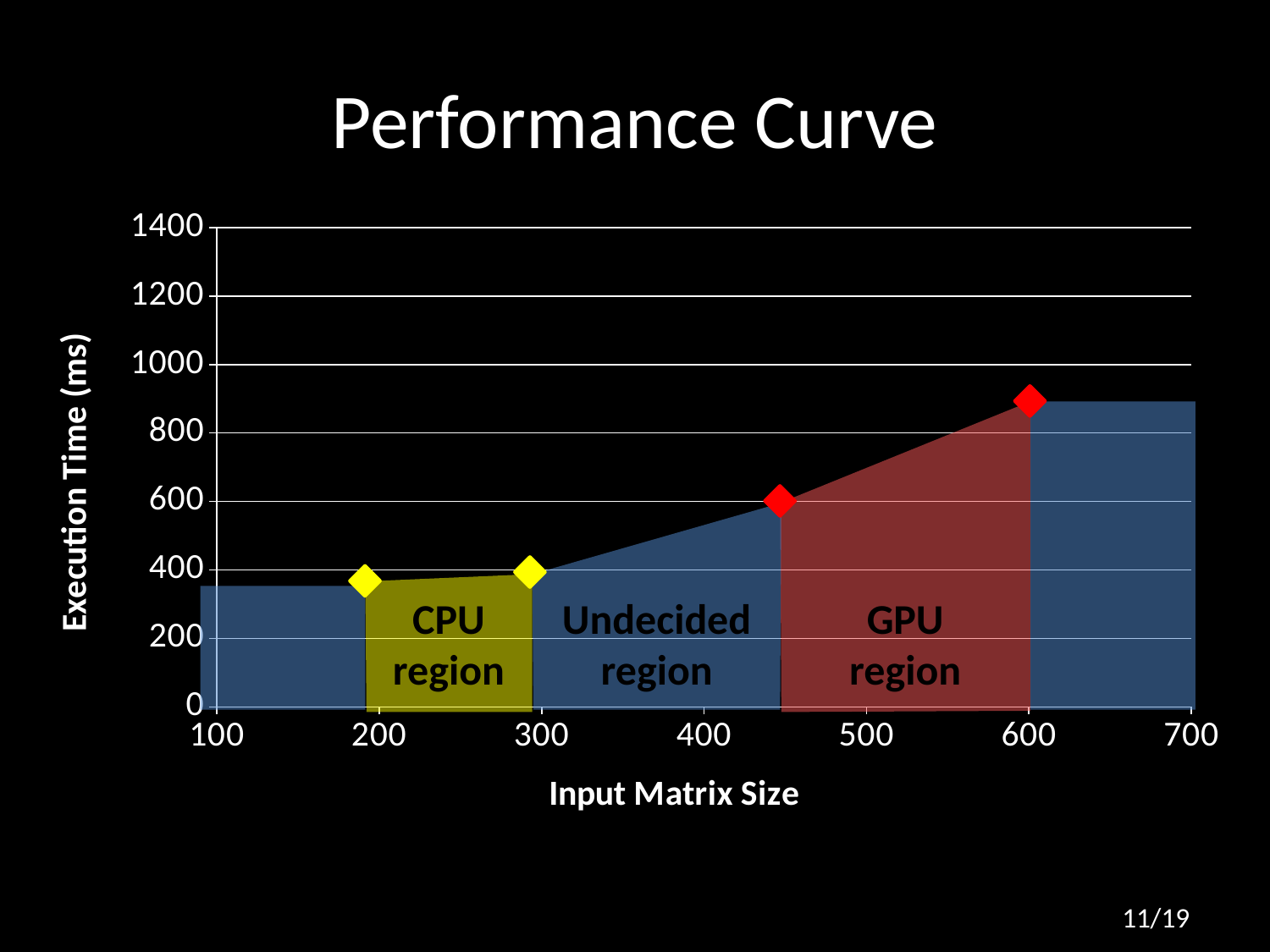
How many tick labels are shown on the x axis? 7 Is the execution time at an input matrix size of 700 greater or less than 800? greater Is the execution time at an input matrix size of 300 greater or less than 600? less What type of chart is shown on the slide? area chart Does the execution time generally rise or fall as the input matrix size increases from 100 to 700? rise Is the execution time at an input matrix size of 100 greater or less than 400? less Which has the larger execution time: an input matrix size of 300 or 600? 600 What are the three labeled regions on the chart? CPU region, Undecided region, GPU region Which has the larger execution time: an input matrix size of 100 or 700? 700 What is the title of the chart? Performance Curve